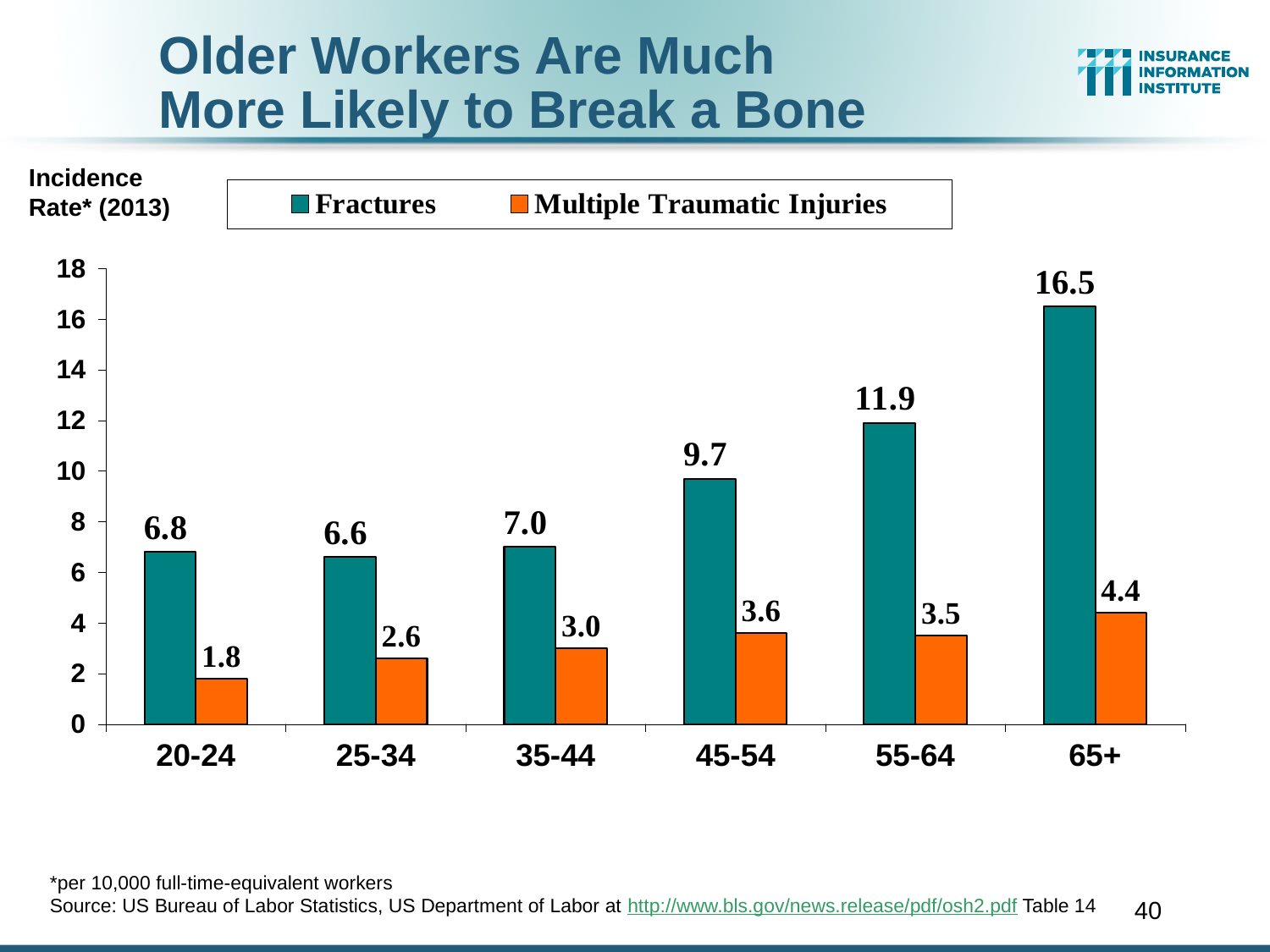
What is the Fractures incidence rate for the 65+ age group? 16.5 Which age group has the lowest Multiple Traumatic Injuries incidence rate? 20-24 How many series does the legend list? 2 Is the Fractures rate for the 55-64 age group greater or less than 10? greater What is the Fractures incidence rate for the 45-54 age group? 9.7 What kind of chart is shown on the slide? Bar chart How many age groups are shown on the x axis? 6 Which series is shown in orange in the legend? Multiple Traumatic Injuries Which is larger: the Multiple Traumatic Injuries rate for 45-54 or for 55-64? 45-54 Which age group has the highest Fractures incidence rate? 65+ What is the difference between the Fractures rate for 65+ and the Fractures rate for 55-64? 4.6 What is the Multiple Traumatic Injuries incidence rate for the 25-34 age group? 2.6